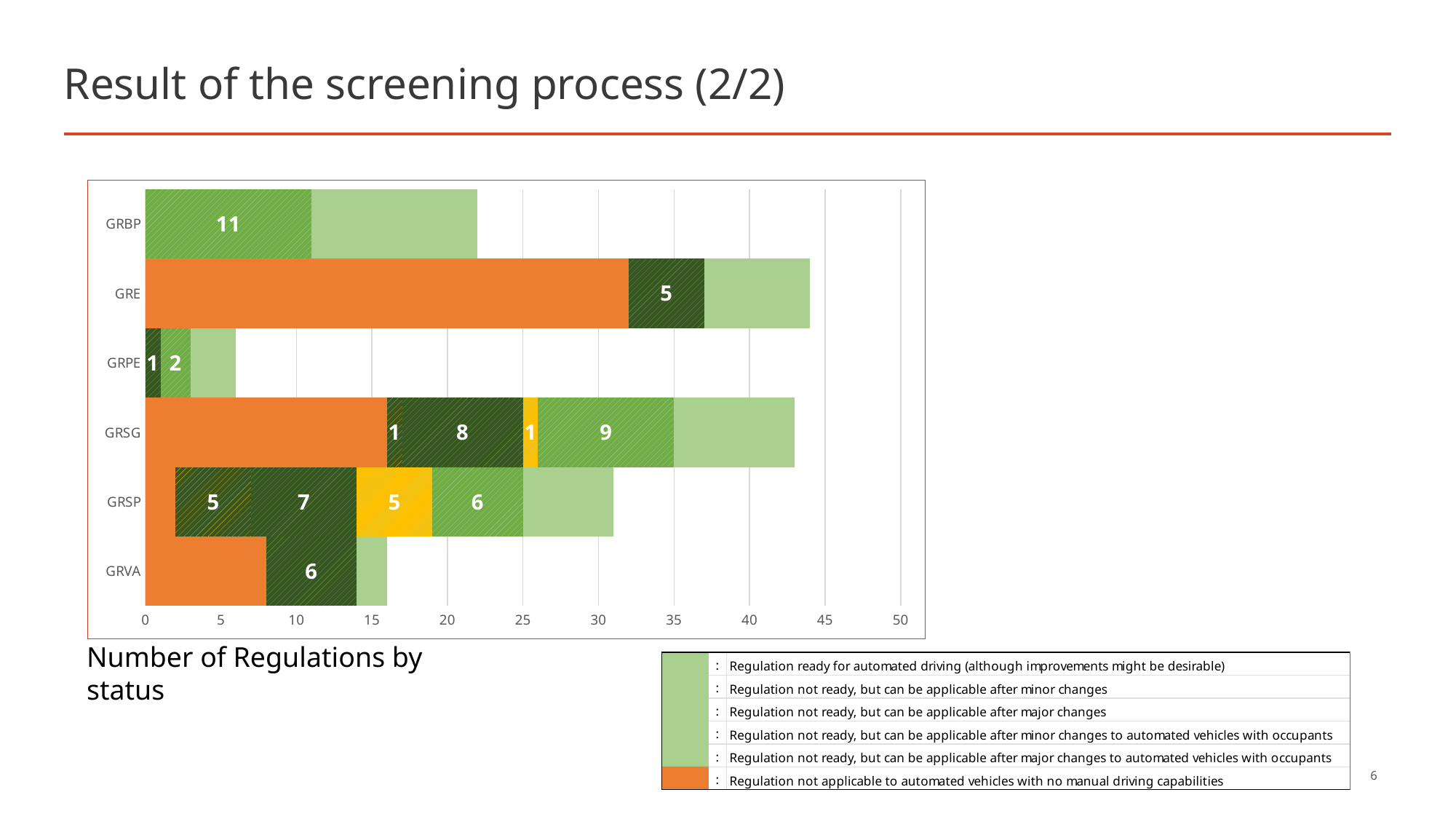
Is the total length of the GRE bar greater or less than 40? greater What value is labelled on the dark green segment of the GRVA bar? 6 What value is labelled on the dark green segment of the GRE bar? 5 Which category has the shortest total bar? GRPE What kind of chart is shown on the slide? bar chart What value is labelled on the yellow segment of the GRSP bar? 5 Which bar is longer in total, GRBP or GRVA? GRBP Is the total length of the GRVA bar greater or less than 20? less What value is labelled on the hatched green segment of the GRBP bar? 11 How many categories (working groups) are shown on the vertical axis of the chart? 6 What is the largest labelled value in the GRSG bar? 9 What is the difference between the two largest labelled values in the GRSG bar (9 and 8)? 1